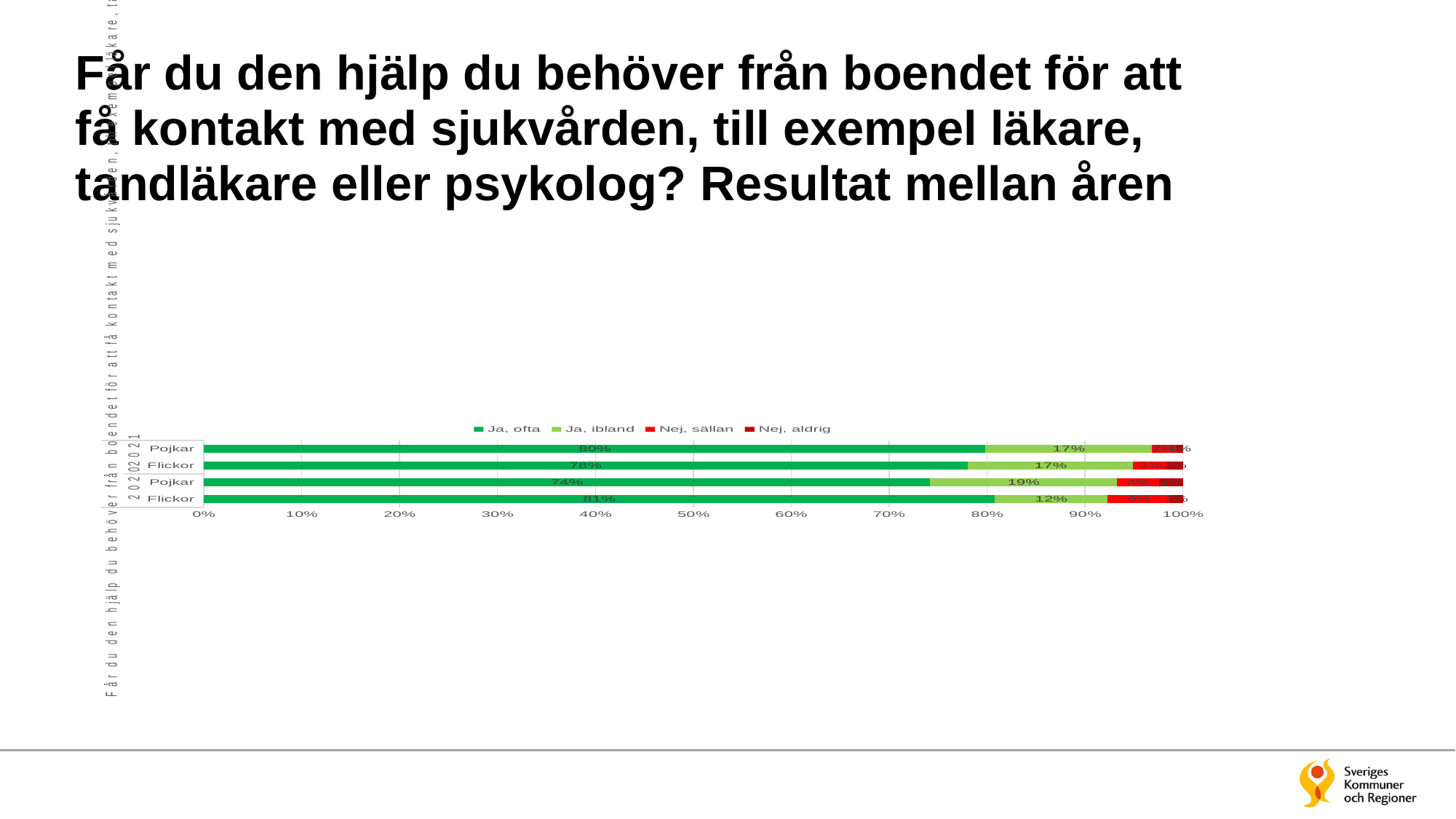
Which bar has the lowest 'Ja, ofta' value? Pojkar 2020 How many series does the chart legend list? 4 What is the difference between the 'Ja, ofta' values for Pojkar in 2021 and Pojkar in 2020? 6 percentage points What is the 'Ja, ofta' value for Flickor in 2020? 81% Which bar has the highest 'Ja, ofta' value? Flickor 2020 What is the 'Ja, ofta' value for Flickor in 2021? 78% How many bars are plotted in the chart? 4 What is the first entry in the chart legend? Ja, ofta Which has the larger 'Ja, ibland' value, Flickor 2021 or Flickor 2020? Flickor 2021 What is the 'Ja, ofta' value for Pojkar in 2021? 80% What kind of chart is shown on the slide? Stacked bar chart What is the 'Ja, ibland' value for Pojkar in 2020? 19%